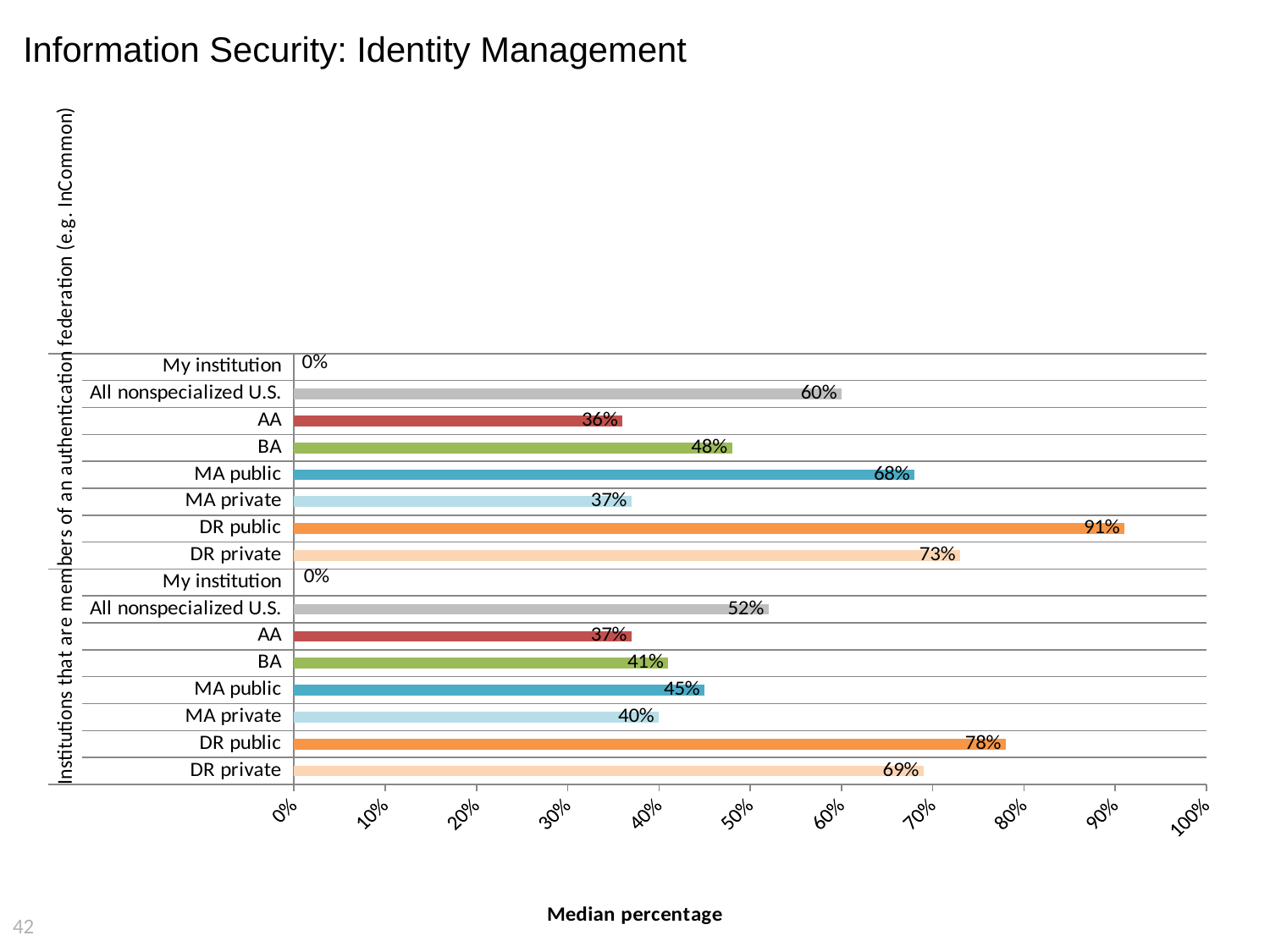
In the lower group of bars, which category has the highest value? DR public In the upper group of bars, what is the difference between DR public and DR private? 18% What type of chart is shown on the slide? bar chart In the upper group of bars, which is larger, BA or AA? BA In the lower group of bars, what is the difference between MA public and MA private? 5% In the lower group of bars, what is the value for All nonspecialized U.S.? 52% In the lower group of bars, what is the value for DR private? 69% What is the title of the horizontal axis? Median percentage In the upper group of bars, what is the value for MA public? 68% In the upper group of bars, which category has the highest value? DR public In the upper group of bars, what is the value for DR public? 91%